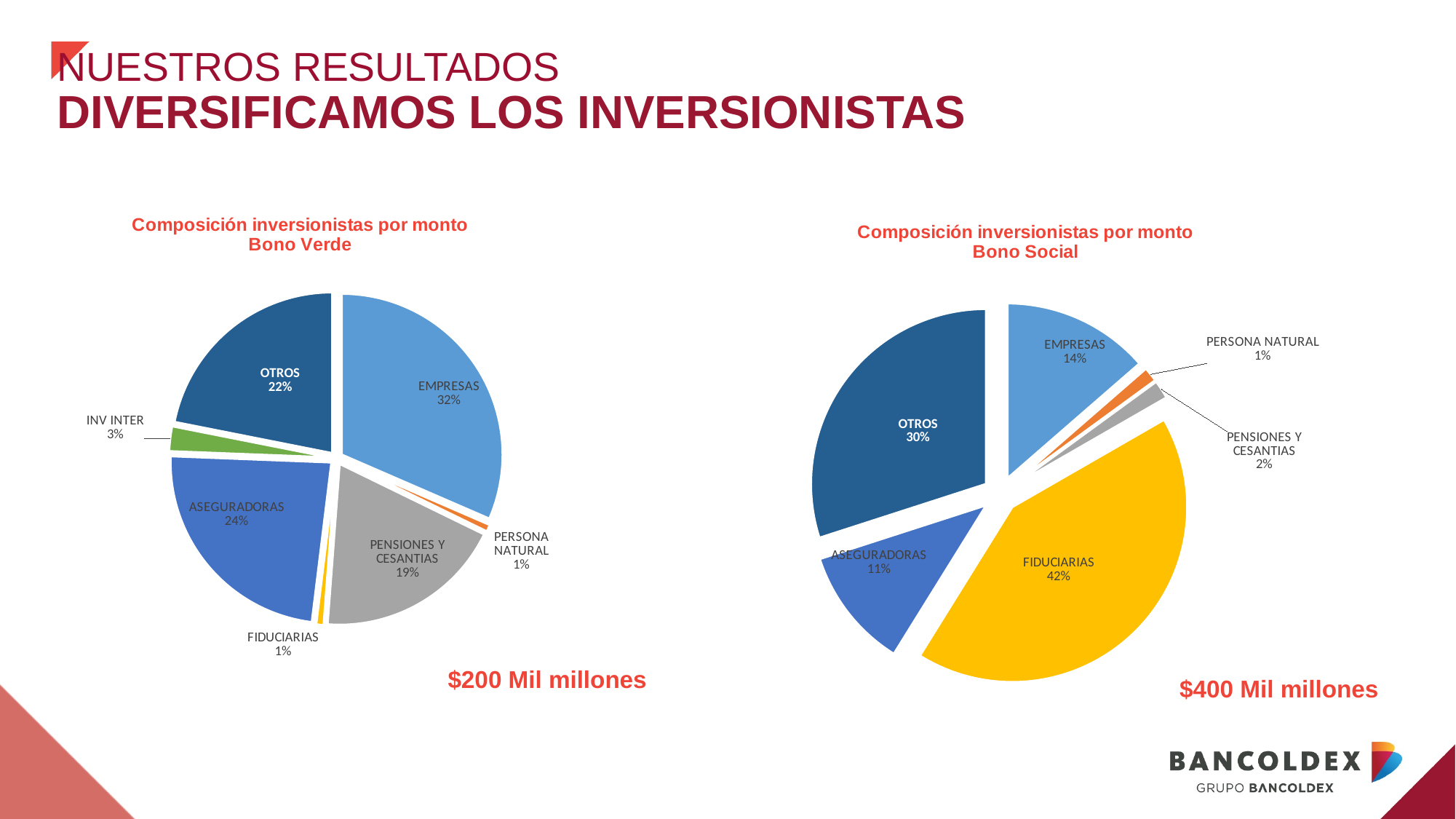
How many categories are shown in the Bono Verde pie chart? 7 In the Bono Verde pie chart, which is larger: the OTROS share or the ASEGURADORAS share? ASEGURADORAS In the Bono Social pie chart, what is the difference between the OTROS share and the EMPRESAS share? 16% What type of chart is used for the Bono Social composition? Pie chart In the Bono Verde pie chart, what is the difference between the ASEGURADORAS share and the PENSIONES Y CESANTIAS share? 5% In the Bono Social pie chart, what share do FIDUCIARIAS hold? 42% How many categories are shown in the Bono Social pie chart? 6 In the Bono Verde pie chart, which category has the largest share? EMPRESAS In the Bono Verde pie chart, what share do EMPRESAS hold? 32% In the Bono Social pie chart, which category has the smallest share? PERSONA NATURAL What total amount is shown below the Bono Social pie chart? $400 Mil millones In the Bono Social pie chart, which category has the largest share? FIDUCIARIAS